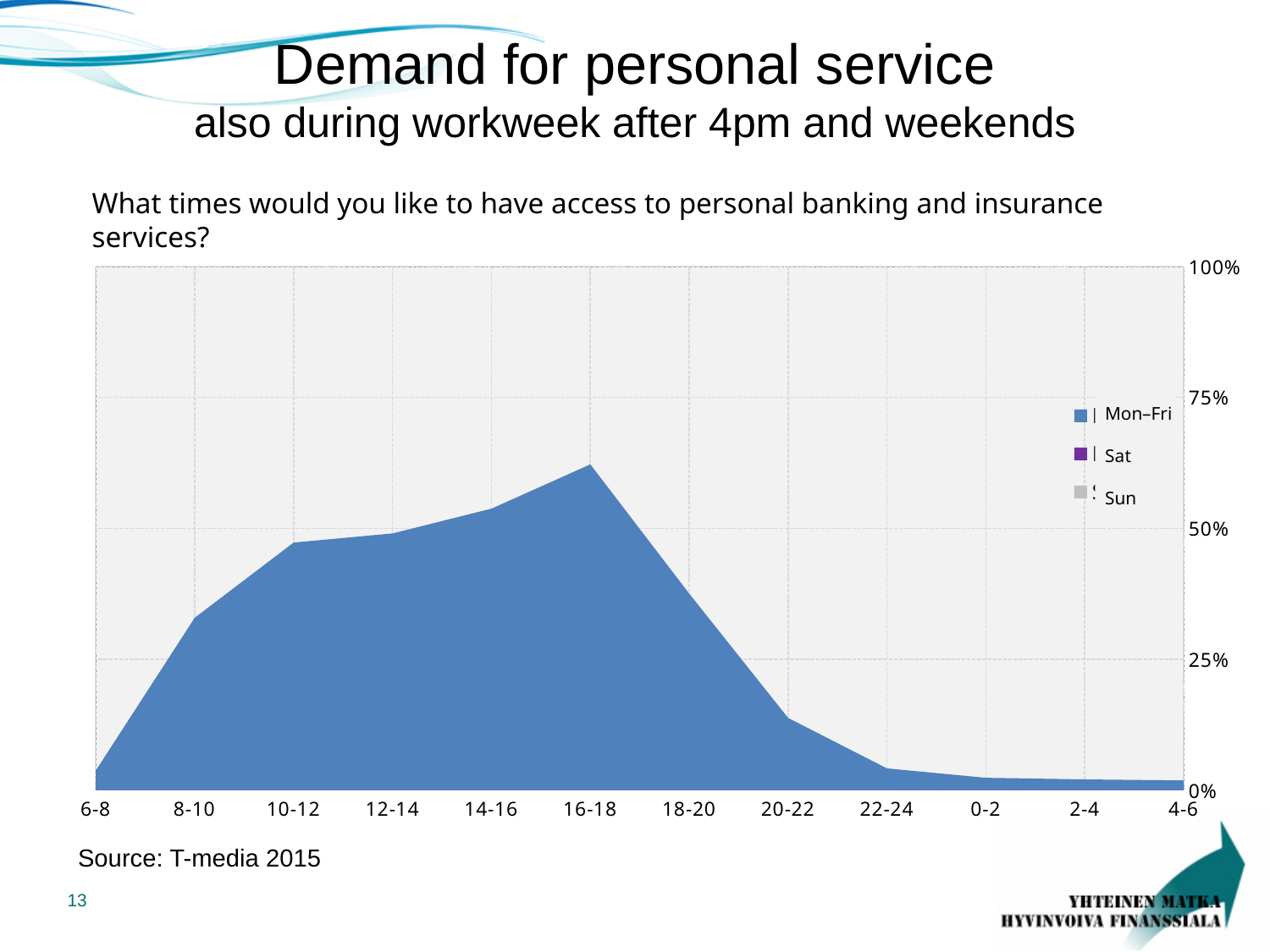
How many series does the legend list? 3 Is the Mon–Fri value for 8-10 greater or less than 25%? greater Is the Mon–Fri value for 16-18 greater or less than 50%? greater Do the Mon–Fri values rise or fall from 16-18 to 22-24? fall Is the Mon–Fri value for 18-20 greater or less than 25%? greater Which time slot has the highest Mon–Fri value? 16-18 Which has the larger Mon–Fri value, 18-20 or 20-22? 18-20 How many time-slot categories are shown on the x axis? 12 What kind of chart is shown on the slide? Area chart Which has the larger Mon–Fri value, 16-18 or 8-10? 16-18 Which series is listed first in the legend? Mon–Fri